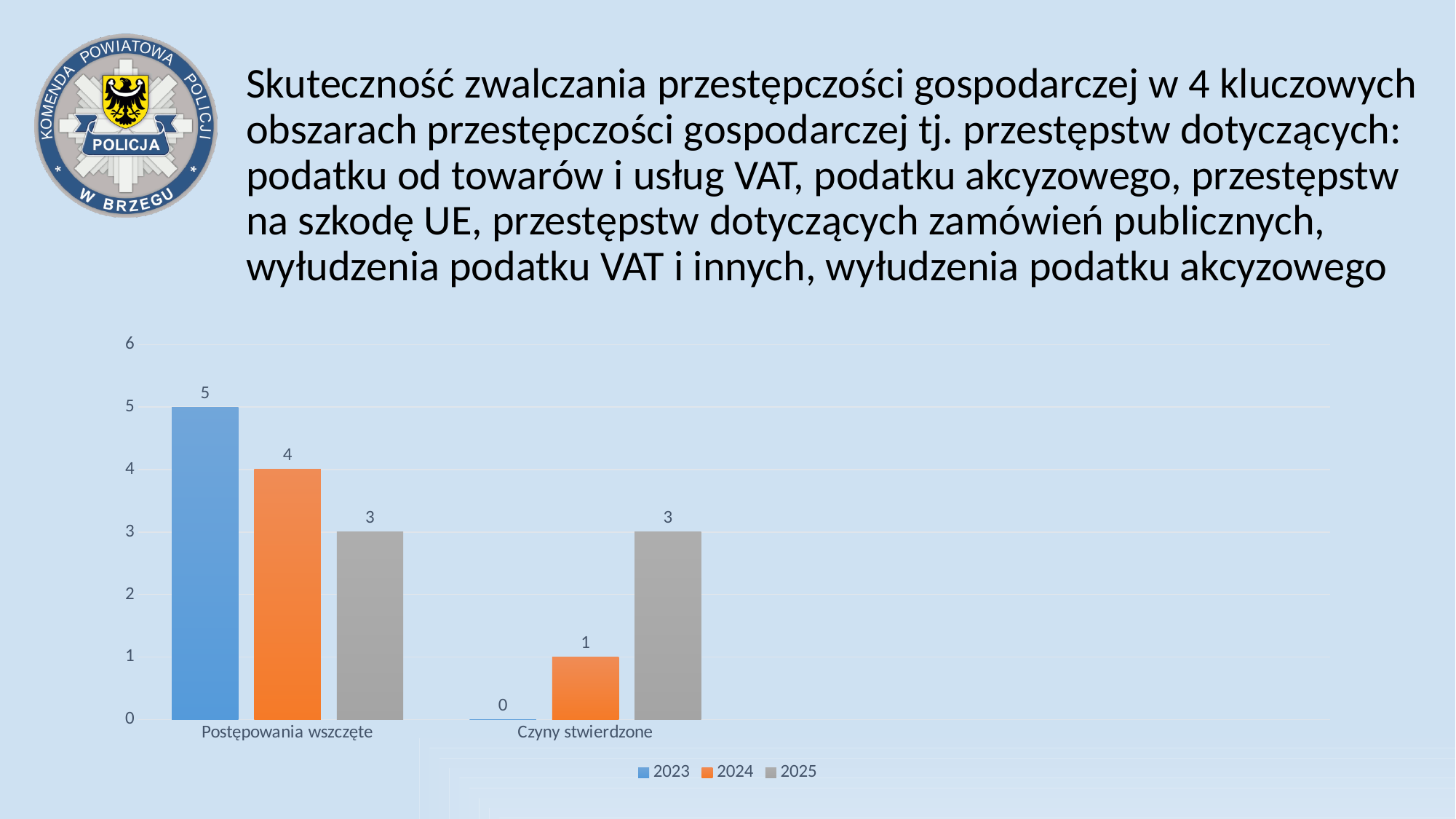
What kind of chart is shown on the slide? Bar chart What is the value for 2023 in the Postępowania wszczęte category? 5 Which colour represents the 2025 series in the legend? Grey What is the value for 2024 in the Czyny stwierdzone category? 1 What is the difference between the 2023 and 2025 values for Postępowania wszczęte? 2 How many series does the legend list? 3 Which year has the lowest value in the Czyny stwierdzone category? 2023 What is the value for 2023 in the Czyny stwierdzone category? 0 What is the value for 2025 in the Postępowania wszczęte category? 3 Which year has the highest value in the Postępowania wszczęte category? 2023 Which is larger: the 2024 value for Postępowania wszczęte or the 2024 value for Czyny stwierdzone? Postępowania wszczęte How many categories are shown on the x axis? 2